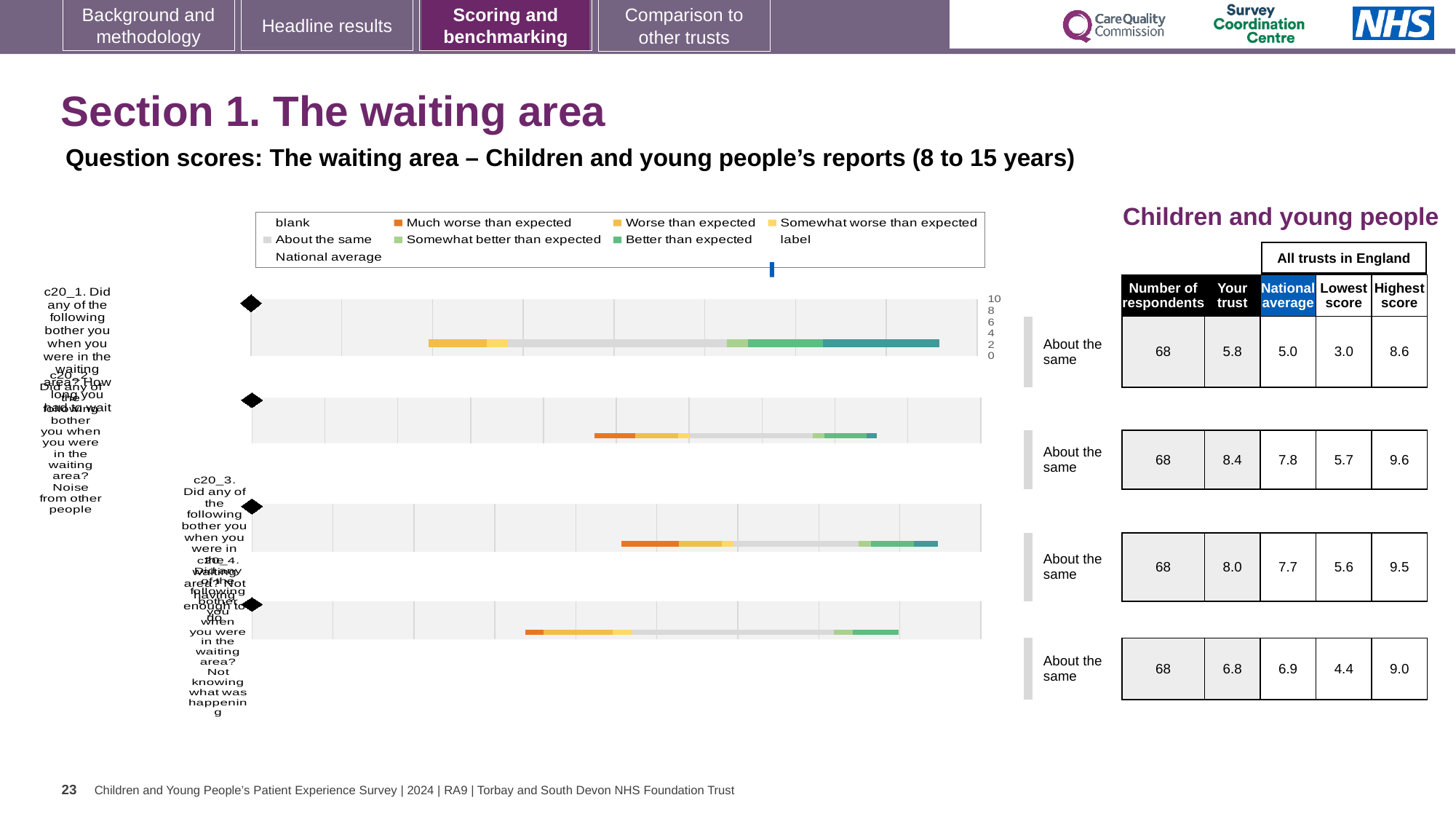
Which question has the lowest 'Your trust' score? c20_1 What colour does the legend use for 'Much worse than expected'? Orange How many respondents answered the first question (c20_1)? 68 What is the 'Your trust' score for the second question (c20_2) in the table beside the chart? 8.4 How many questions (bars) are plotted in the chart? 4 What kind of chart is shown on the slide? bar chart What is the lowest score across all trusts in England for the fourth question (c20_4)? 4.4 Which question has the highest 'Your trust' score? c20_2 What is the difference between the 'Your trust' scores for c20_2 and c20_1? 2.6 What is the highest score across all trusts in England for the third question (c20_3)? 9.5 For the fourth question (c20_4), which is larger: the 'Your trust' score or the national average? National average What is the national average score for the first question (c20_1)? 5.0